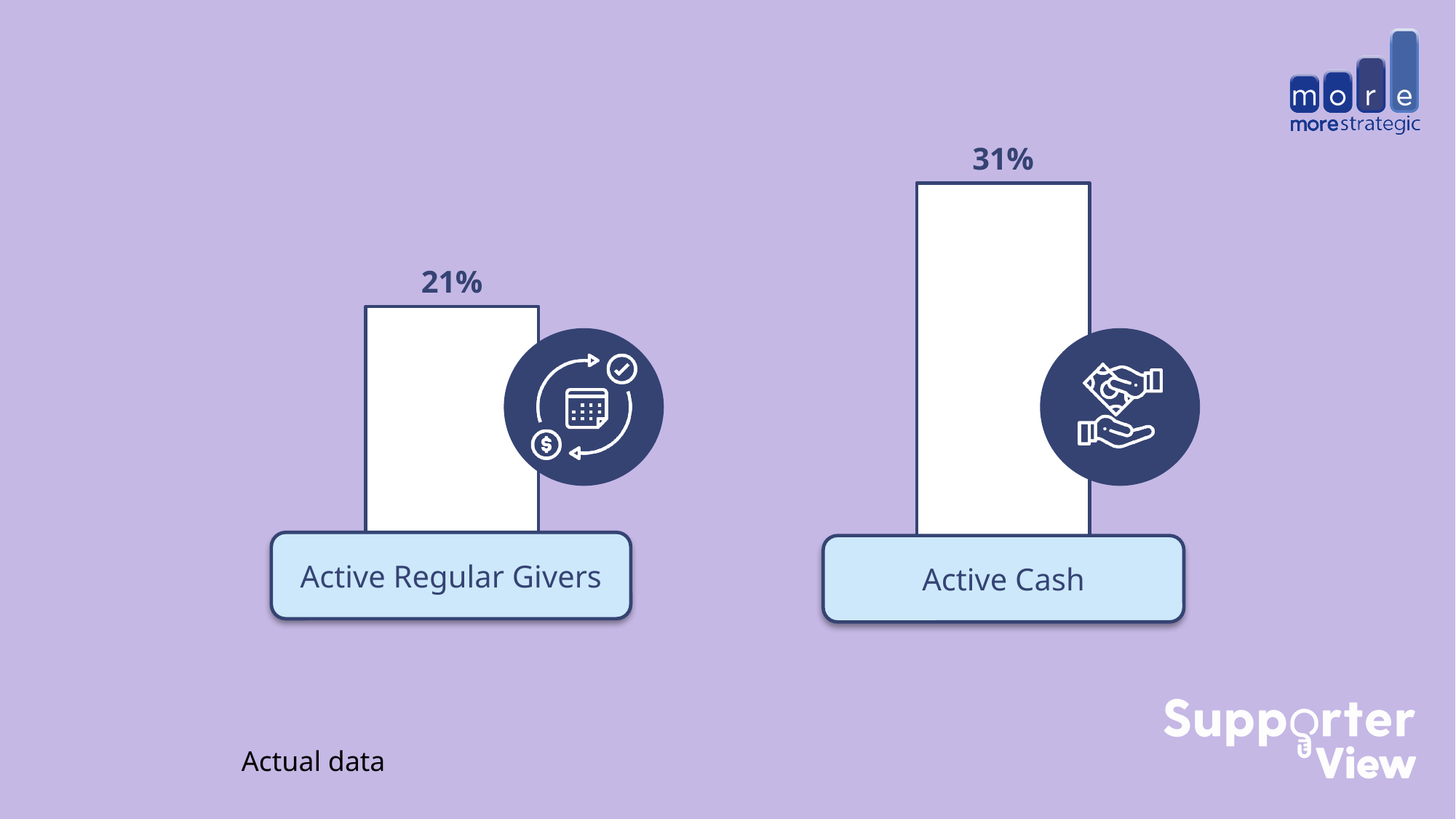
Which category has the higher value? Active Cash Is the value for Active Regular Givers larger or smaller than the value for Active Cash? smaller What is the difference between the Active Cash value and the Active Regular Givers value? 10% What kind of chart is shown on the slide? bar chart What text appears in the bottom-left corner of the slide describing the data? Actual data Which category has the lower value? Active Regular Givers How many categories are shown in the chart? 2 What is the value shown for Active Cash? 31% What is the value shown for Active Regular Givers? 21% What colour are the bars in the chart? white